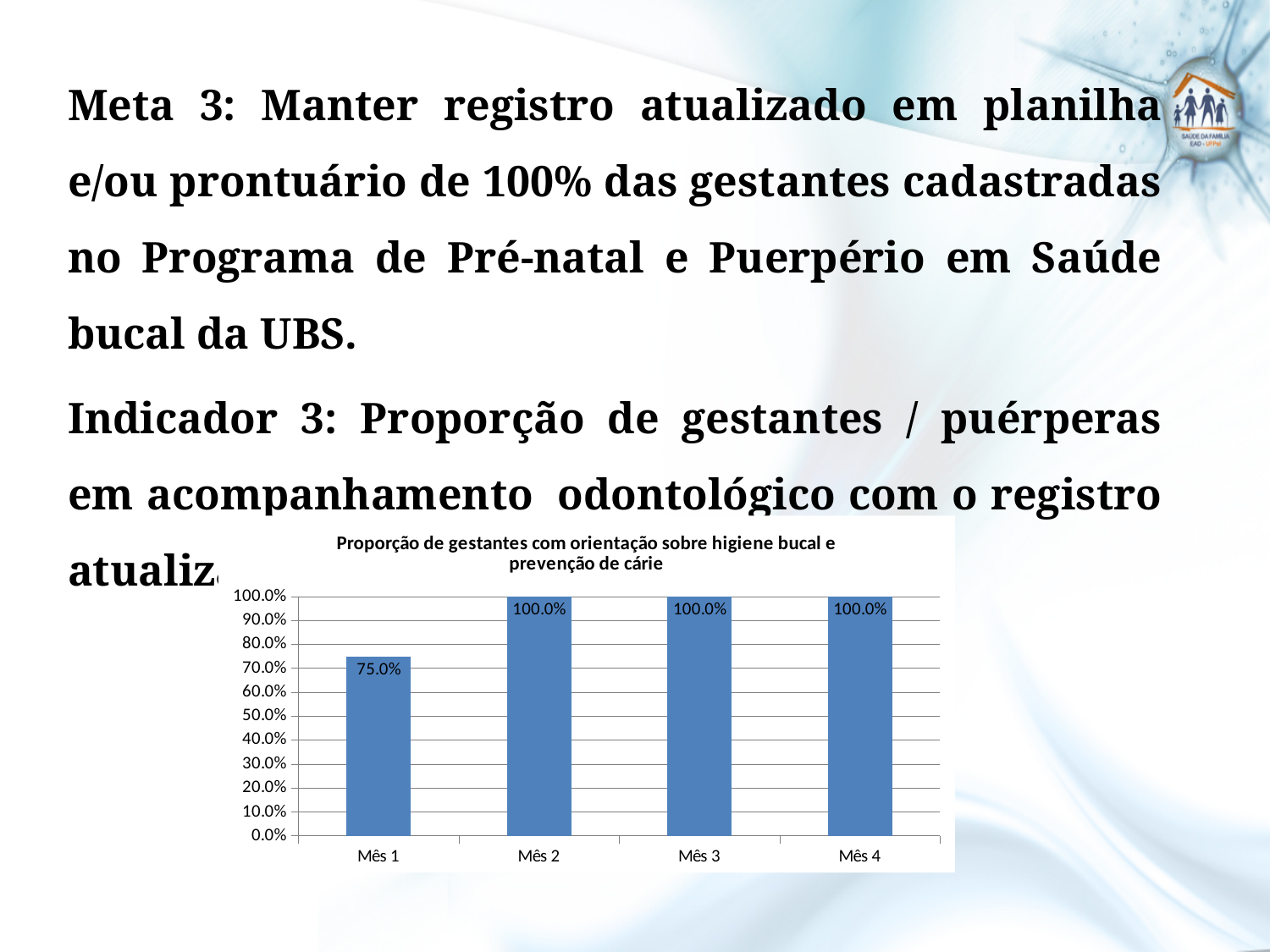
What is the difference between the values for Mês 2 and Mês 1? 25.0% What kind of chart is shown on the slide? bar chart Do the values rise or fall from Mês 1 to Mês 2? rise What is the value for Mês 1? 75.0% Which month has the lowest value? Mês 1 What is the title of the chart? Proporção de gestantes com orientação sobre higiene bucal e prevenção de cárie What is the value for Mês 2? 100.0% Which is larger, the value for Mês 1 or the value for Mês 3? Mês 3 Is the value for Mês 1 greater or less than 80.0%? less How many months are shown on the x axis? 4 What is the value for Mês 4? 100.0% What colour are the bars in the chart? blue